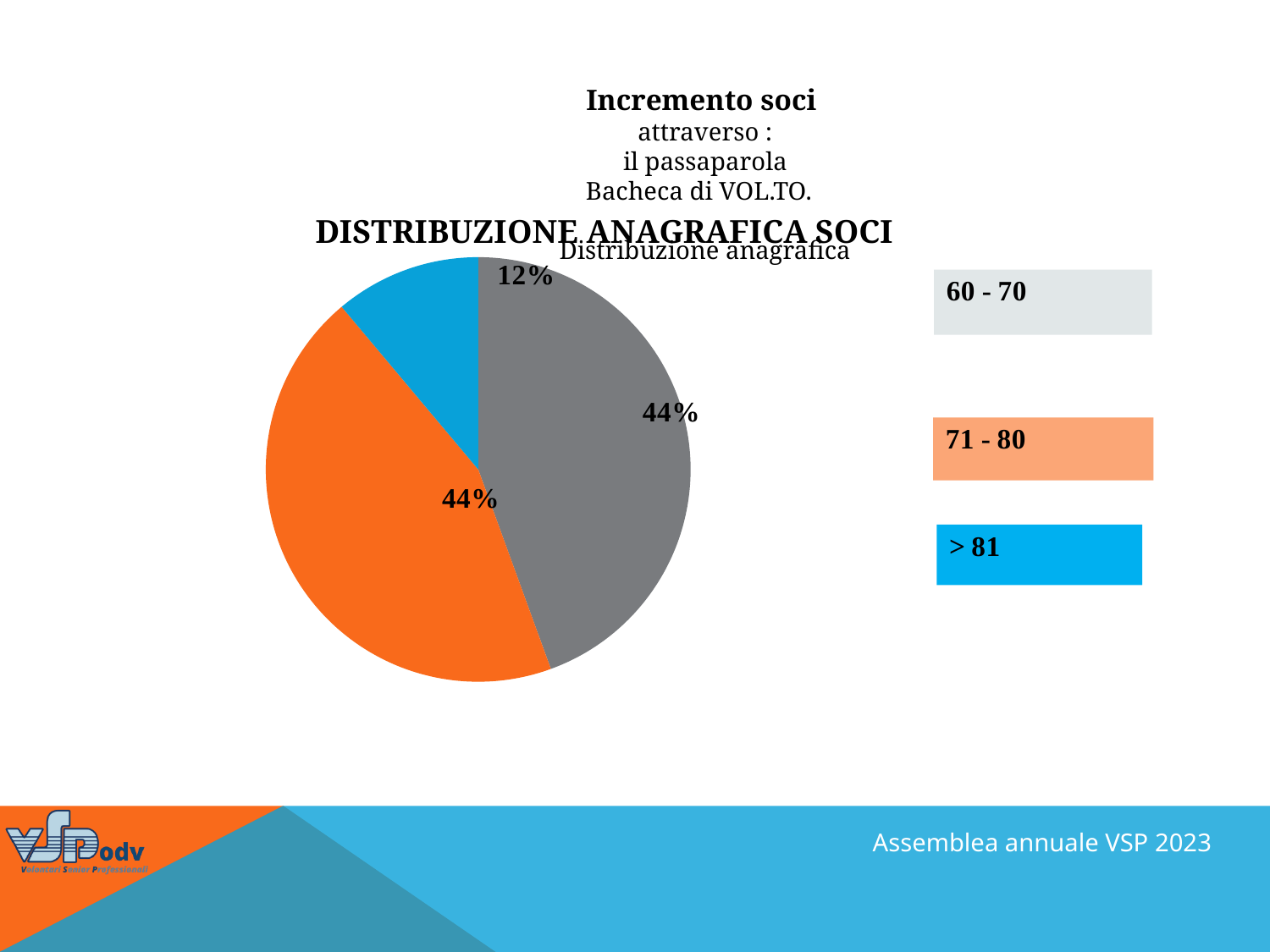
What is the title printed directly above the pie chart? Distribuzione anagrafica What colour is the slice for the "> 81" age group? blue What share of the pie does the "71 - 80" age group represent? 44% Which is larger, the slice for "60 - 70" or the slice for "> 81"? 60 - 70 What share of the pie does the "> 81" age group represent? 12% What kind of chart is shown on the slide? pie chart What is the difference in percentage points between the "71 - 80" slice and the "> 81" slice? 32 How many slices does the pie chart have? 3 What share of the pie does the "60 - 70" age group represent? 44% How many age groups are listed in the legend to the right of the pie chart? 3 Which age group has the smallest slice of the pie? > 81 Is the share for "> 81" greater or less than 20%? less